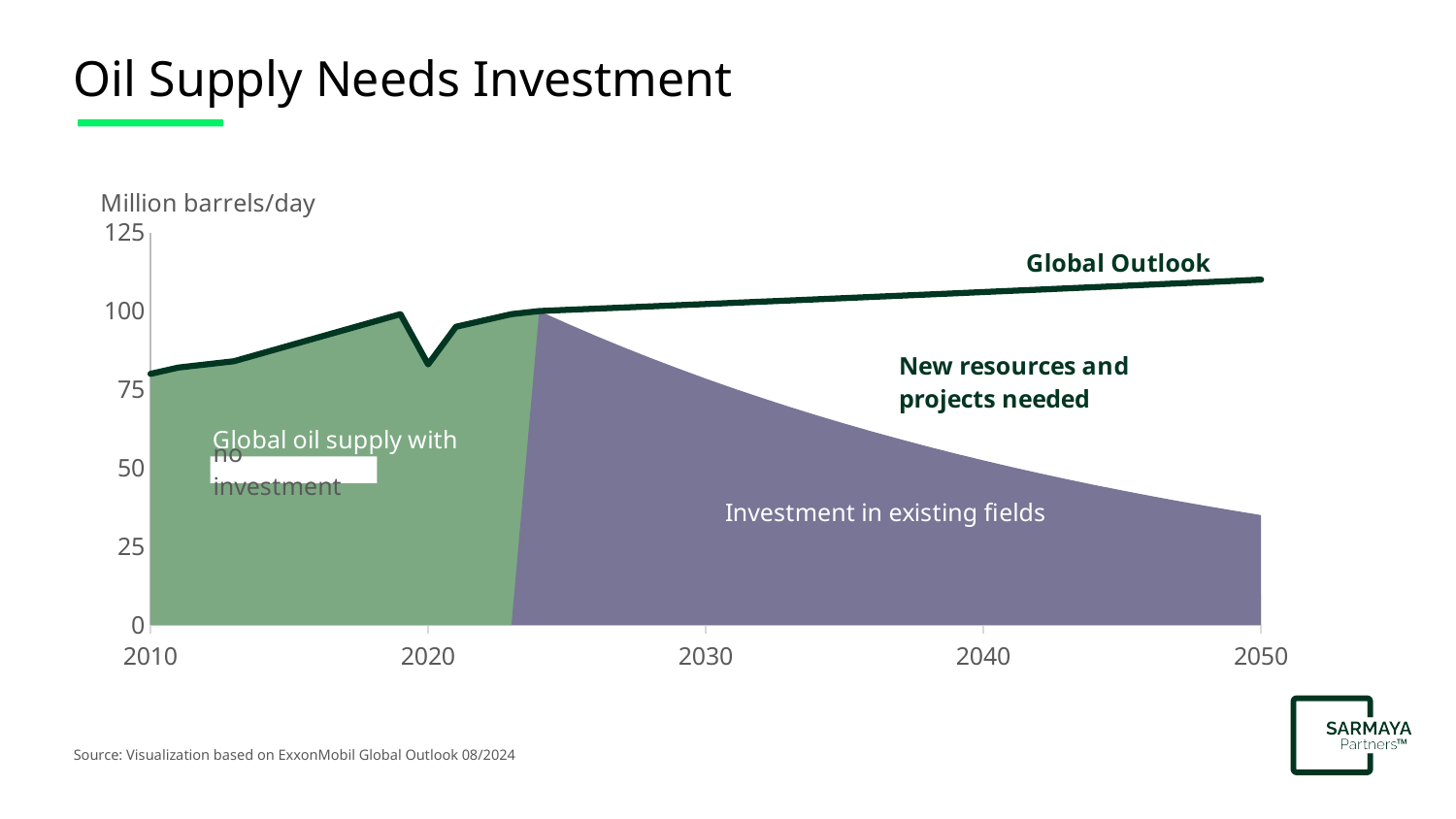
Does the 'Investment in existing fields' area rise or fall from about 2024 to 2050? fall Is the Global Outlook value in 2010 greater or less than 75? greater Is the Global Outlook value in 2050 greater or less than 100? greater Is the value of the 'Investment in existing fields' area in 2040 greater or less than 75? less Does the Global Outlook line rise or fall overall from 2010 to 2050? rise How many year labels are shown on the x axis? 5 What kind of chart is shown on the slide? Area chart Which is larger in 2050: the Global Outlook line or the 'Investment in existing fields' area? Global Outlook What is the title of the slide? Oil Supply Needs Investment What unit is shown on the y axis of the chart? Million barrels/day